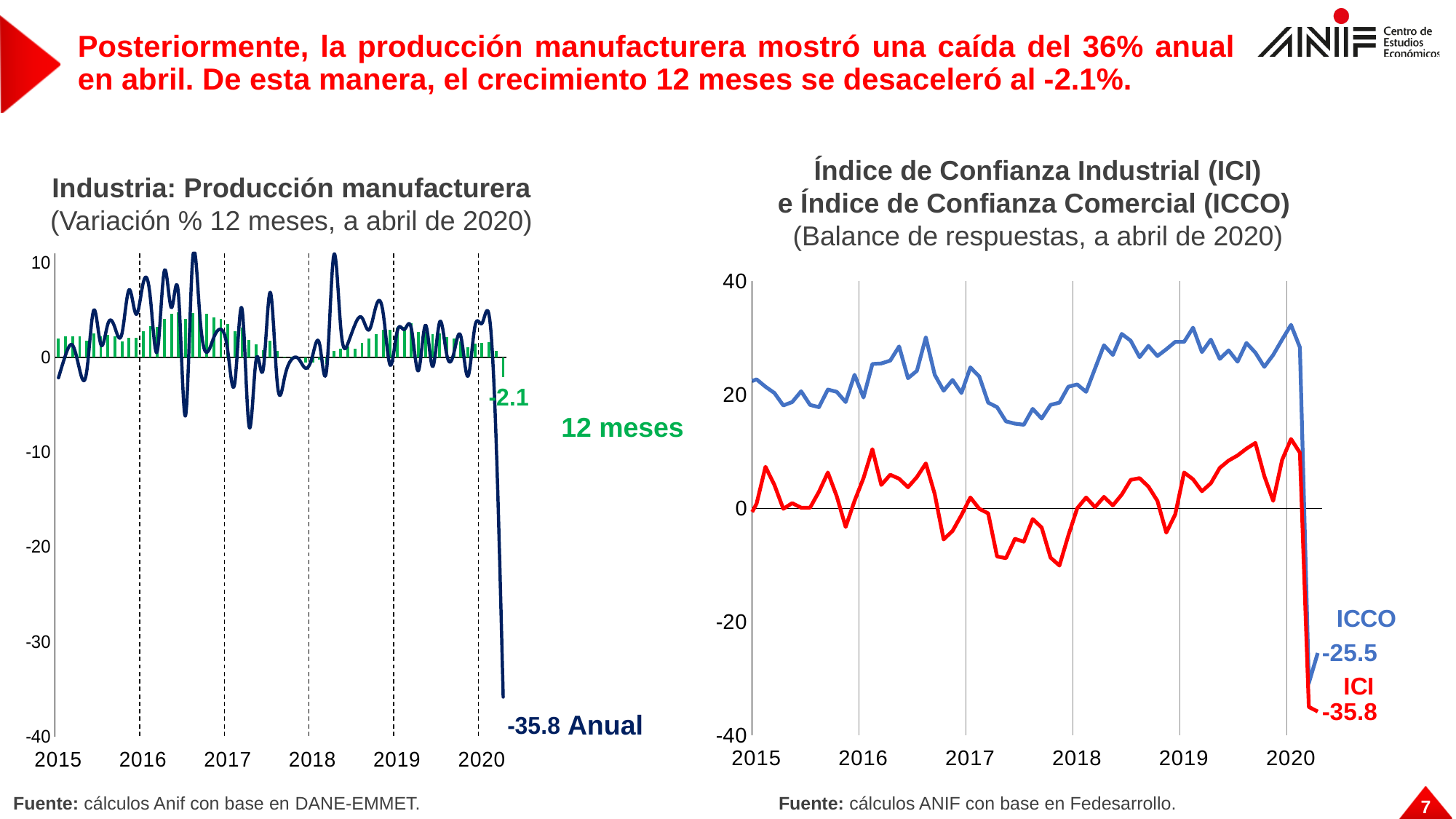
In the 'Índice de Confianza Industrial (ICI) e Índice de Confianza Comercial (ICCO)' chart, what is the latest value of ICCO? -25.5 How many series are plotted in the right-hand chart? 2 In the 'Industria: Producción manufacturera' chart, what is the latest value of the '12 meses' series? -2.1 In the 'Índice de Confianza Industrial (ICI) e Índice de Confianza Comercial (ICCO)' chart, what is the latest value of ICI? -35.8 In the left-hand chart, which series has the lower latest value, 'Anual' or '12 meses'? Anual In the right-hand chart, is the ICCO value at the start of 2015 greater or less than 20? greater In the right-hand chart, which series has the higher latest value, ICI or ICCO? ICCO In the left-hand chart, what is the difference between the latest '12 meses' value and the latest 'Anual' value? 33.7 In the right-hand chart, what is the difference between the latest ICCO value and the latest ICI value? 10.3 In the 'Industria: Producción manufacturera' chart, what is the latest value of the 'Anual' series? -35.8 What is the source cited for the 'Índice de Confianza Industrial (ICI) e Índice de Confianza Comercial (ICCO)' chart? cálculos ANIF con base en Fedesarrollo In the right-hand chart, is the ICI value at the start of 2015 greater or less than 20? less